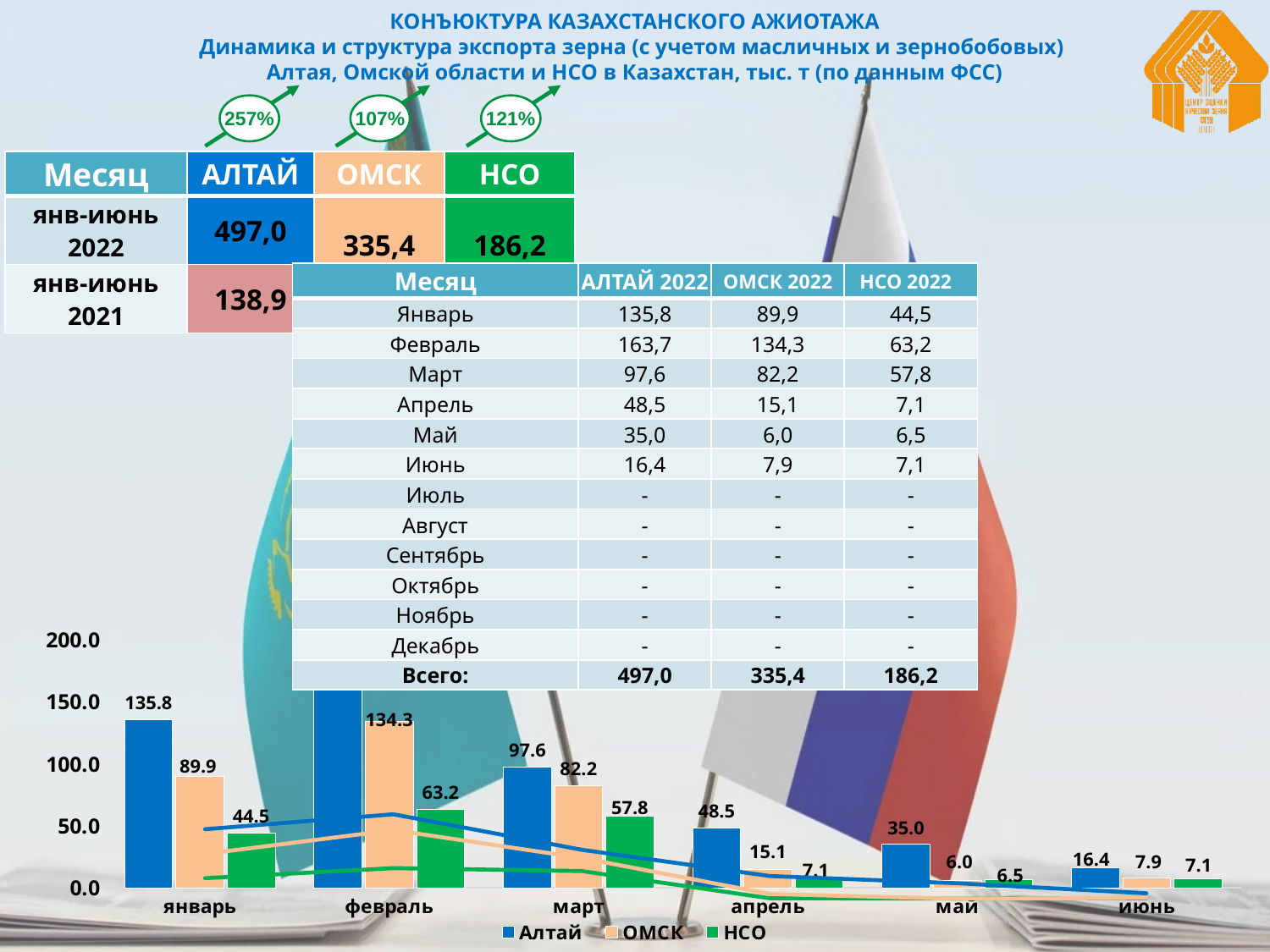
In the bar chart, what is the value for Алтай in январь? 135.8 In the bar chart, is the value for Алтай in февраль greater or less than 150? greater In the bar chart, what is the difference between the Алтай and ОМСК values in январь? 45.9 In the bar chart, do the Алтай values rise or fall from март to июнь? fall In the bar chart, what is the value for ОМСК in февраль? 134.3 How many series does the legend of the bar chart list? 3 In the bar chart, which month has the highest value for ОМСК? февраль In the bar chart, what is the value for НСО in март? 57.8 How many months are shown on the x axis of the bar chart? 6 In the bar chart, which month has the lowest value for ОМСК? май In the bar chart, which is larger in май: the value for ОМСК or the value for НСО? НСО What kind of chart is shown at the bottom of the slide? bar chart